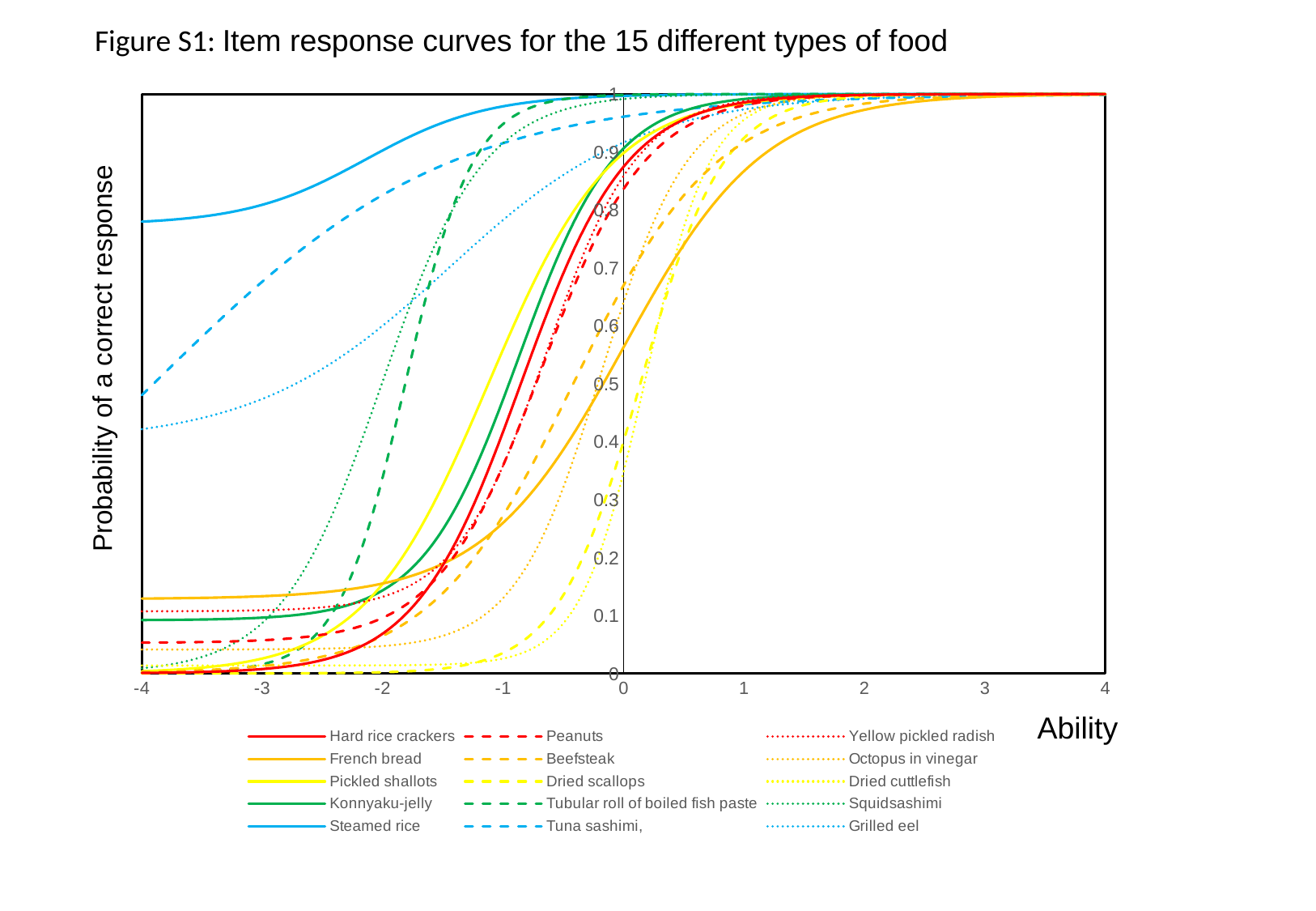
At an ability of -4, which is larger: the value for Steamed rice or the value for French bread? Steamed rice Which series has the highest probability at an ability of -4? Steamed rice Is the value for Steamed rice at an ability of -4 greater or less than 0.5? greater What kind of chart is shown on the slide? Line chart What is the title of the figure? Figure S1: Item response curves for the 15 different types of food Is the value for Grilled eel at an ability of -4 greater or less than 0.5? less Do the curves rise or fall as Ability increases along the x axis? Rise How many series does the legend list? 15 Is the value for Dried cuttlefish at an ability of 0 greater or less than 0.5? less At an ability of -3, which is larger: the value for Tuna sashimi or the value for Grilled eel? Tuna sashimi What is the label of the vertical axis? Probability of a correct response